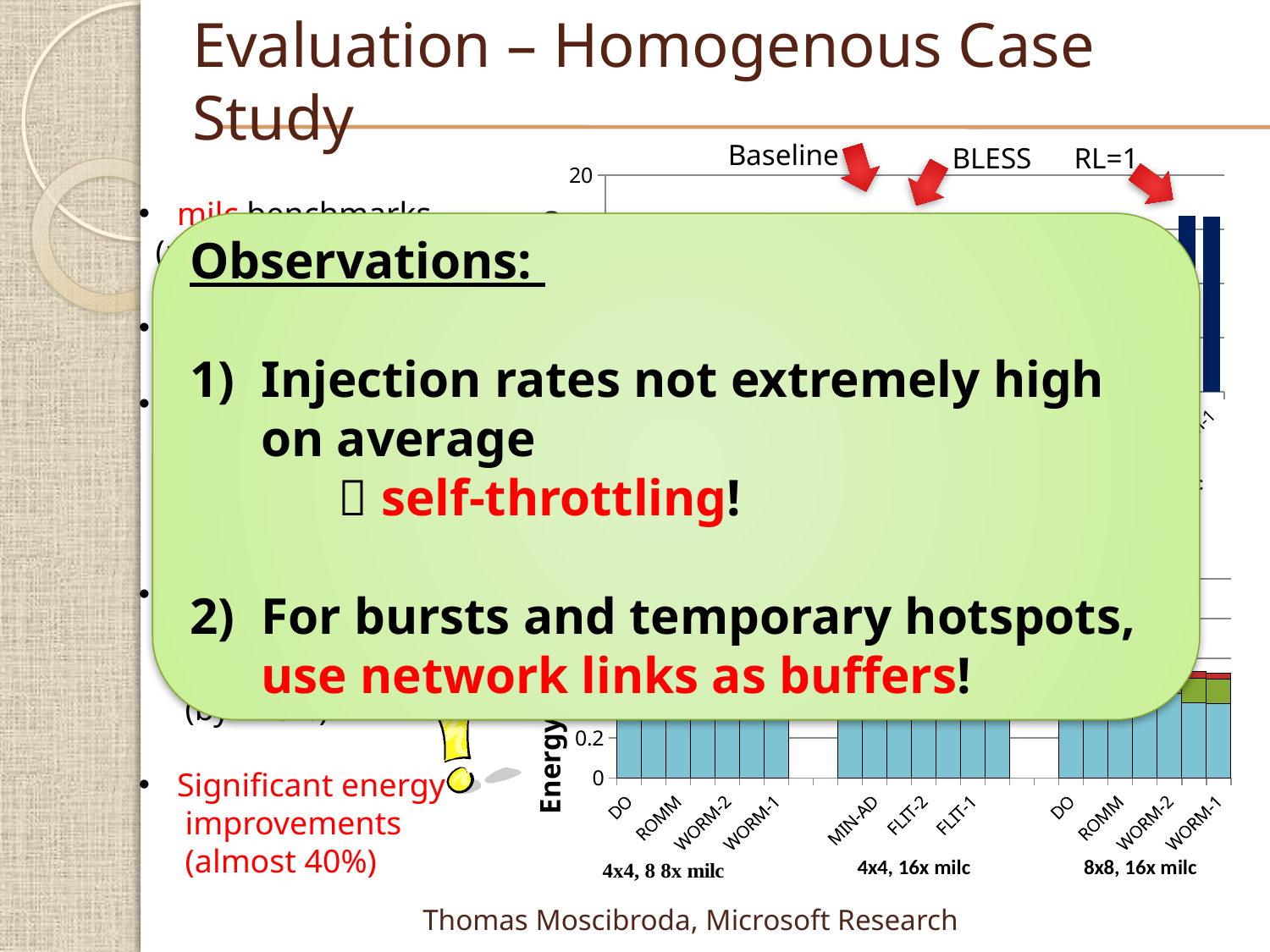
On the lower chart, is the Energy value for WORM-1 in the 8x8, 16x milc group greater or less than 0.2? greater On the lower chart, is the Energy value for DO in the 4x4, 8 8x milc group greater or less than 0.2? greater On the upper chart, what is the highest tick value shown on the vertical axis? 20 On the lower chart, what is the label of the rightmost configuration group? 8x8, 16x milc On the upper chart, which three labels are pointed to by the red arrows above the bars? Baseline, BLESS, RL=1 On the lower chart, which three categories make up the middle group (4x4, 16x milc)? MIN-AD, FLIT-2, FLIT-1 On the lower chart, what is the label of the first (leftmost) configuration group? 4x4, 8 8x milc On the lower chart, how many categories are labelled along the x axis? 11 On the lower chart, what is the label on the vertical axis? Energy On the lower chart, how many configuration groups are labelled beneath the x axis? 3 What kind of chart is the lower chart on the slide (the one with the Energy axis)? bar chart